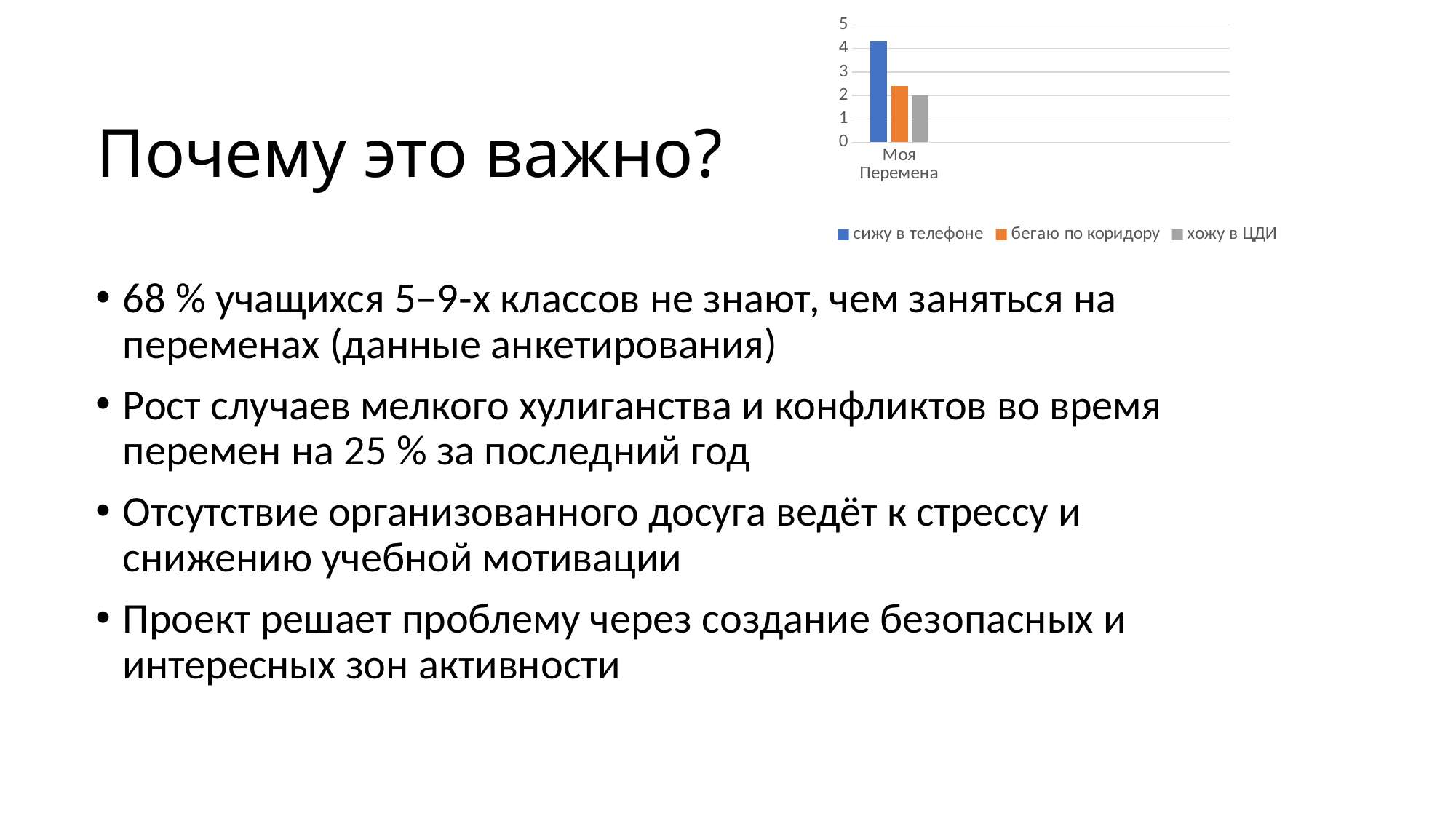
What colour is used for the series сижу в телефоне in the chart? blue What kind of chart is shown on the slide? bar chart What is the category label on the x axis of the chart? Моя Перемена Which series has the lowest bar in the chart? хожу в ЦДИ Which series has the highest bar in the chart? сижу в телефоне How many categories are shown on the x axis of the chart? 1 How many series does the chart legend list? 3 Is the value for бегаю по коридору greater or less than 2? greater Is the value for сижу в телефоне greater or less than 4? greater Which is larger in the chart: the bar for сижу в телефоне or the bar for бегаю по коридору? сижу в телефоне Is the value for бегаю по коридору greater or less than 3? less